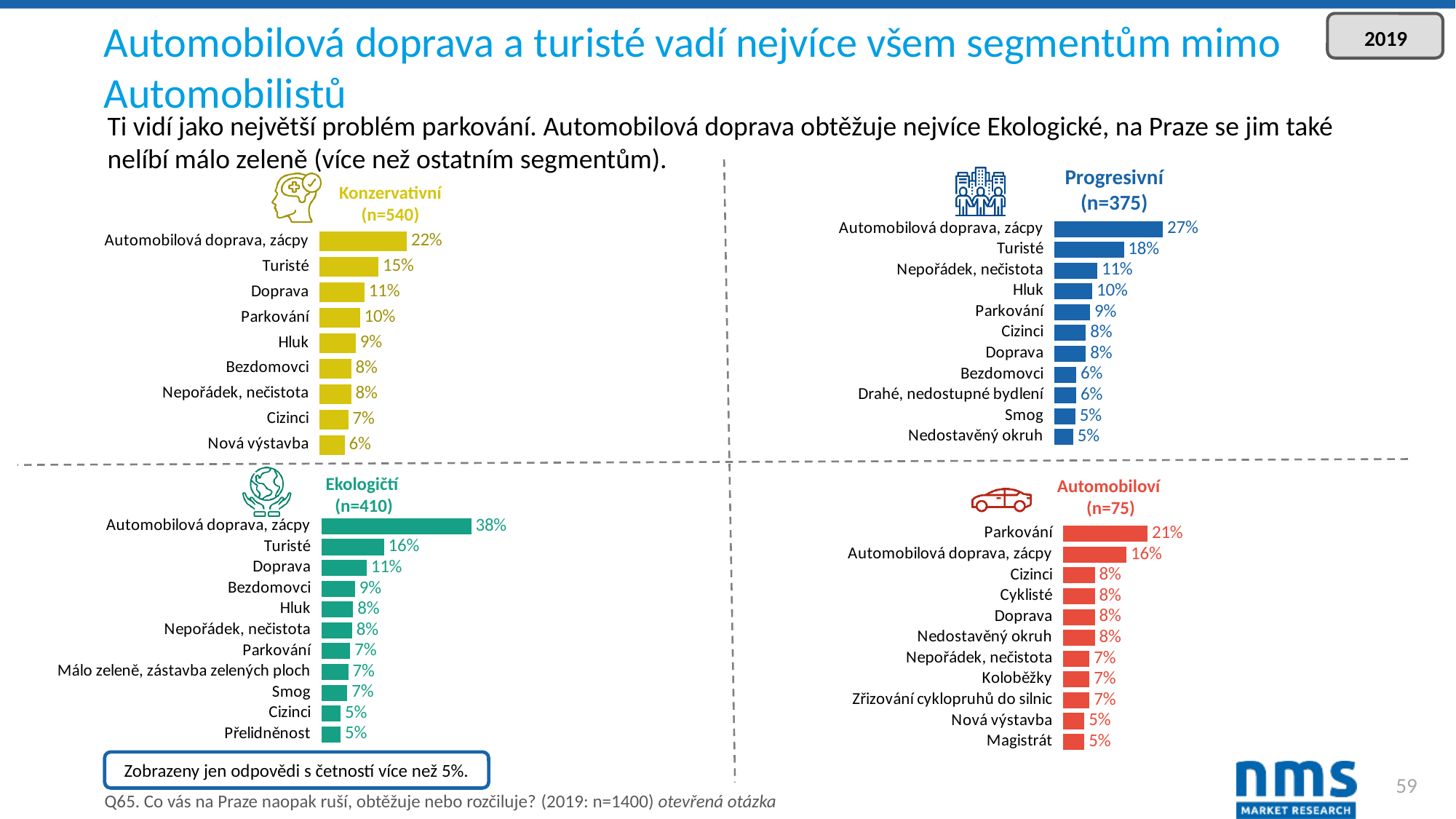
In the Progresivní (n=375) chart, what is the value for Nepořádek, nečistota? 11% In the Konzervativní (n=540) chart, which category has the lowest value? Nová výstavba What type of chart is the Progresivní (n=375) chart? Bar chart In the Konzervativní (n=540) chart, what is the value for Turisté? 15% How many categories are shown in the Automobiloví (n=75) chart? 11 In the Progresivní (n=375) chart, what is the difference between Automobilová doprava, zácpy and Turisté? 9% In the Automobiloví (n=75) chart, which category has the highest value? Parkování In the Ekologičtí (n=410) chart, what is the value for Málo zeleně, zástavba zelených ploch? 7% In the Ekologičtí (n=410) chart, which is larger: Doprava or Bezdomovci? Doprava In the Automobiloví (n=75) chart, what is the difference between Parkování and Automobilová doprava, zácpy? 5% In the Ekologičtí (n=410) chart, which category has the highest value? Automobilová doprava, zácpy How many categories are shown in the Konzervativní (n=540) chart? 9